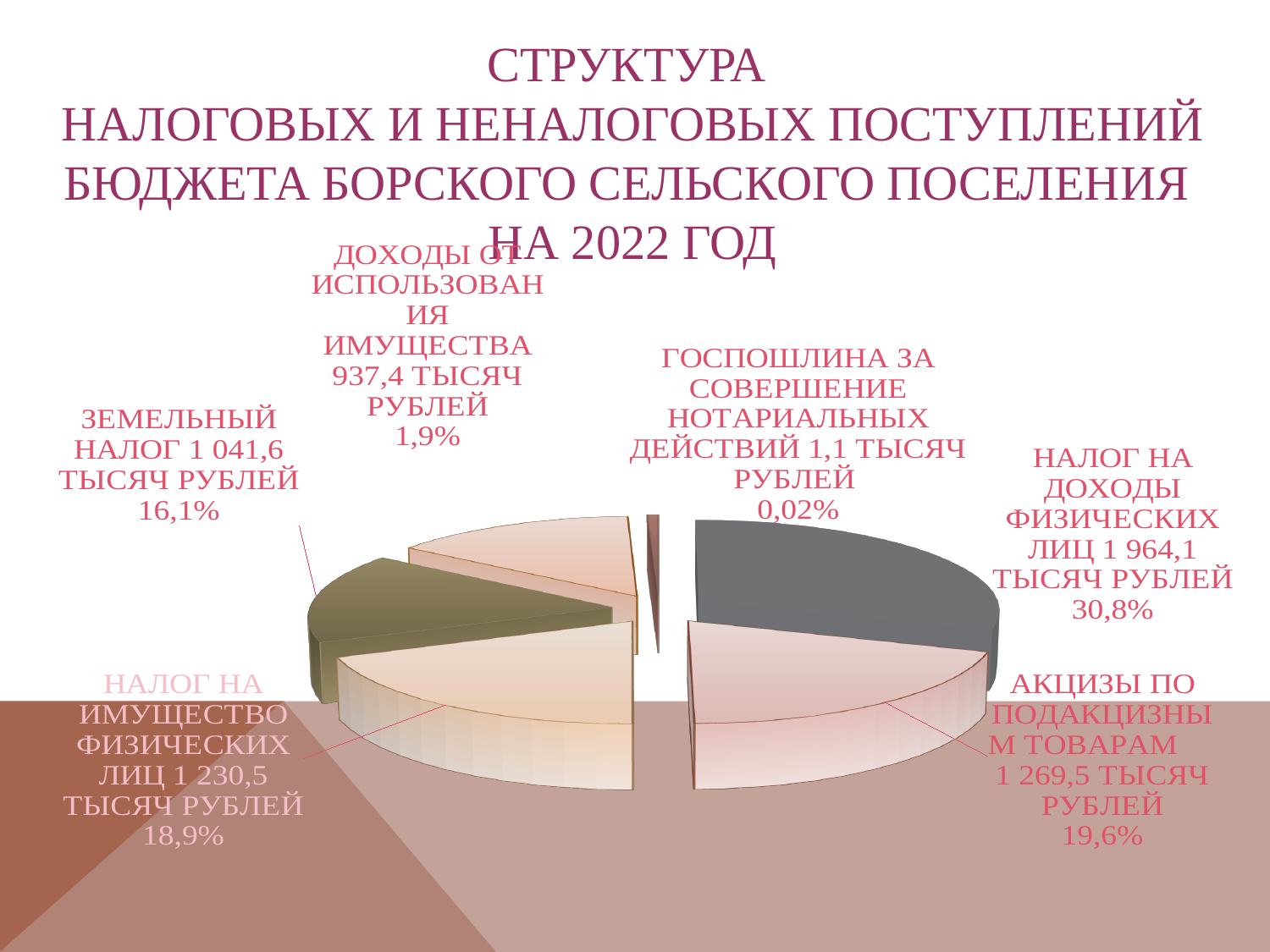
How many categories (slices) does the pie chart have? 6 Which is larger, the share of АКЦИЗЫ ПО ПОДАКЦИЗНЫМ ТОВАРАМ or the share of ЗЕМЕЛЬНЫЙ НАЛОГ? АКЦИЗЫ ПО ПОДАКЦИЗНЫМ ТОВАРАМ What is the value shown for ЗЕМЕЛЬНЫЙ НАЛОГ in thousand rubles? 1 041,6 Which category has the largest share of the pie? НАЛОГ НА ДОХОДЫ ФИЗИЧЕСКИХ ЛИЦ For which year does the chart title say the budget structure is shown? 2022 What share of the pie does НАЛОГ НА ДОХОДЫ ФИЗИЧЕСКИХ ЛИЦ represent? 30,8% What percentage is shown for ГОСПОШЛИНА ЗА СОВЕРШЕНИЕ НОТАРИАЛЬНЫХ ДЕЙСТВИЙ? 0,02% Which category has the smallest share of the pie? ГОСПОШЛИНА ЗА СОВЕРШЕНИЕ НОТАРИАЛЬНЫХ ДЕЙСТВИЙ What percentage is shown for НАЛОГ НА ИМУЩЕСТВО ФИЗИЧЕСКИХ ЛИЦ? 18,9% What is the value shown for АКЦИЗЫ ПО ПОДАКЦИЗНЫМ ТОВАРАМ in thousand rubles? 1 269,5 What kind of chart is shown on the slide? pie chart What is the difference in thousand rubles between НАЛОГ НА ДОХОДЫ ФИЗИЧЕСКИХ ЛИЦ and АКЦИЗЫ ПО ПОДАКЦИЗНЫМ ТОВАРАМ? 694,6